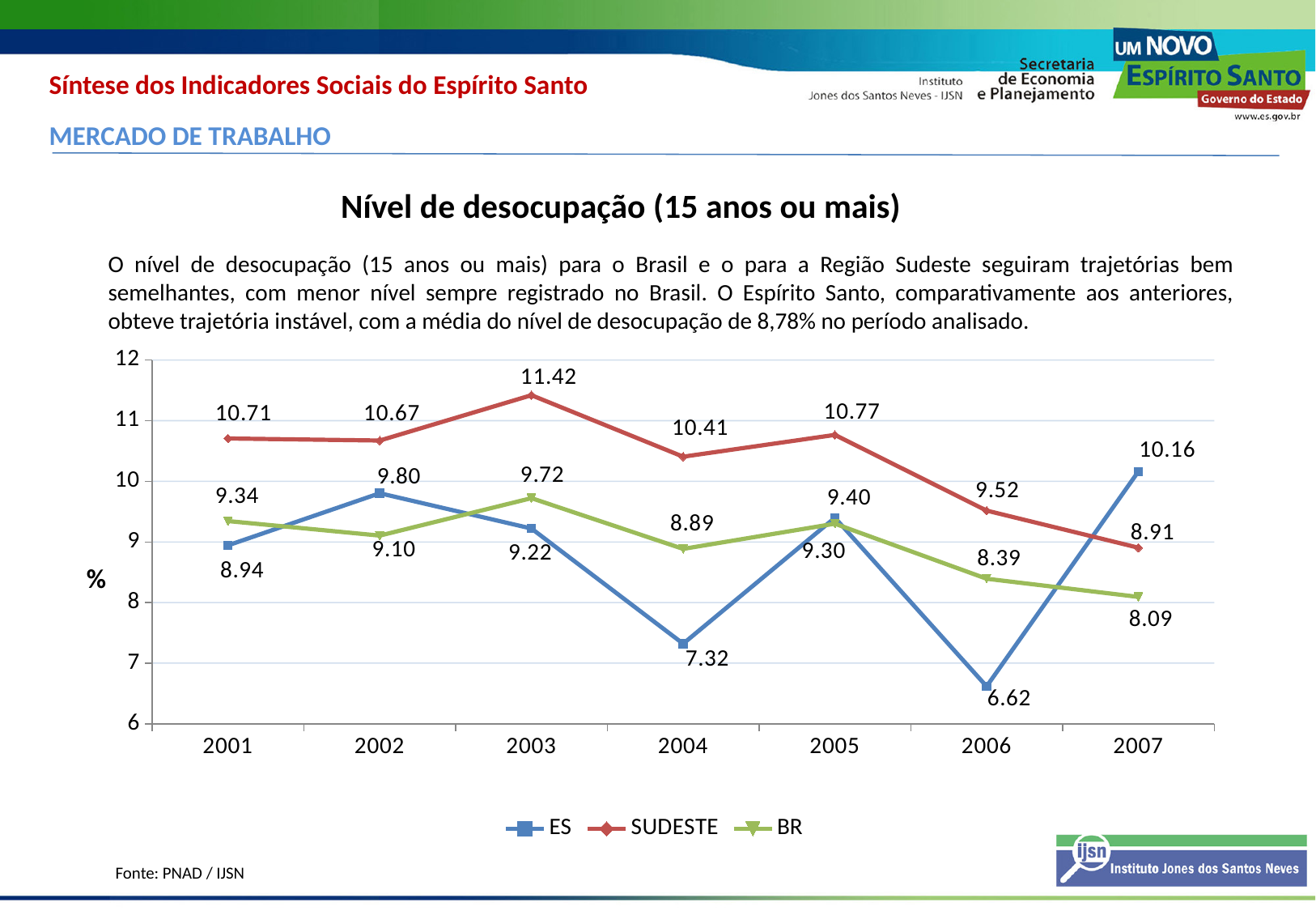
How many series does the legend list? 3 In which year does the SUDESTE series reach its highest value? 2003 In which year does the ES series reach its lowest value? 2006 How many years are plotted on the x axis? 7 What is the difference between the SUDESTE and ES values in 2004? 3.09 What is the value for ES in 2006? 6.62 What is the value for BR in 2007? 8.09 In 2007, which series has the higher value, ES or SUDESTE? ES What is the title of the chart? Nível de desocupação (15 anos ou mais) What is the value for SUDESTE in 2003? 11.42 What type of chart is shown on the slide? line chart Does the BR series rise or fall from 2005 to 2007? fall